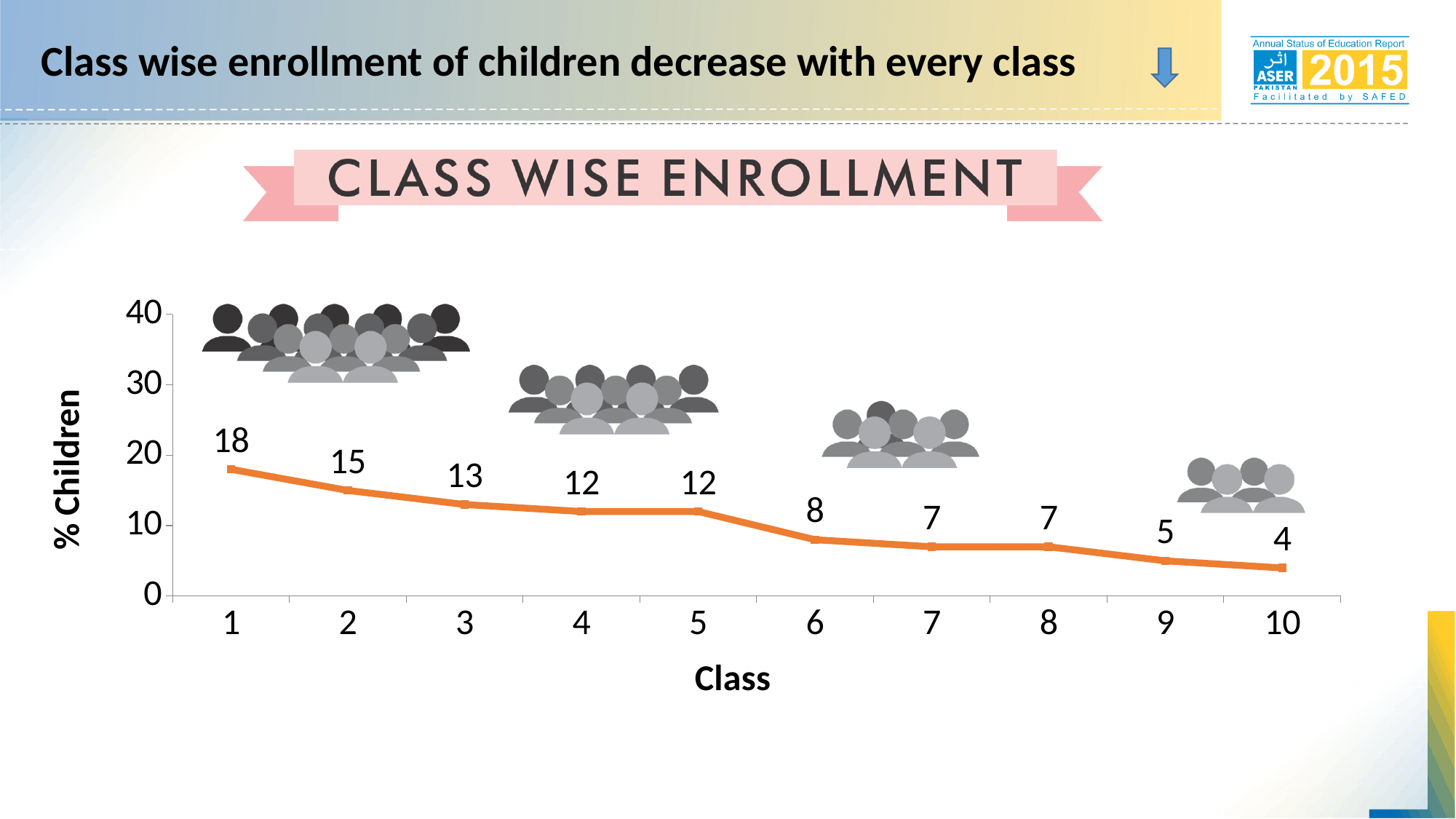
What is the % Children value for Class 1? 18 Which class has the highest % Children? 1 What is the % Children value for Class 6? 8 What kind of chart is shown on the slide? line chart What is the difference in % Children between Class 5 and Class 6? 4 What is the difference in % Children between Class 1 and Class 2? 3 Which has a larger % Children value, Class 3 or Class 9? Class 3 How many classes are plotted on the x axis? 10 Is the value for Class 2 greater or less than 10? greater Which class has the lowest % Children? 10 What is the % Children value for Class 10? 4 Do the % Children values rise or fall as the class number increases? fall